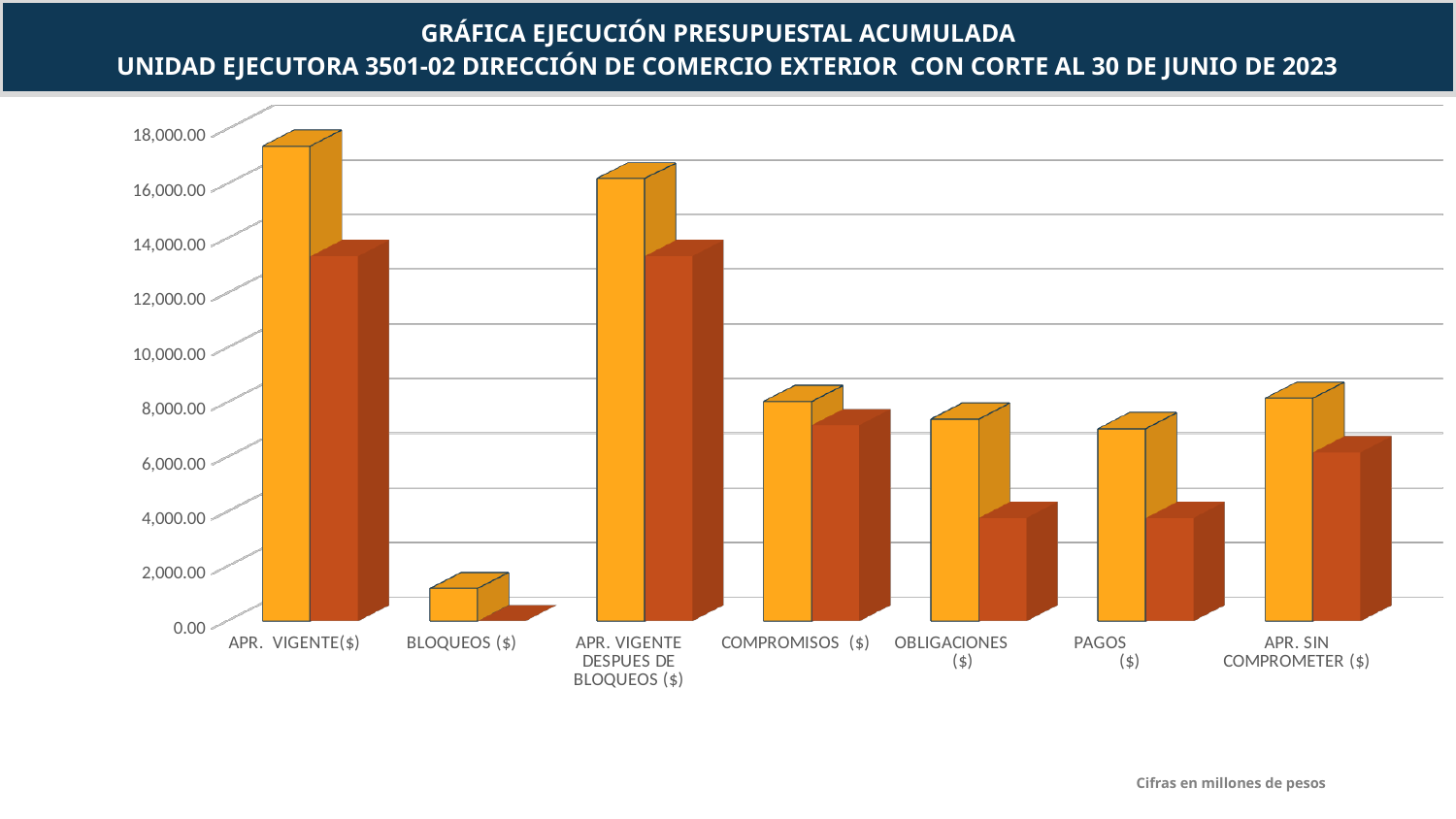
Is the yellow (front) bar for APR. VIGENTE($) greater or less than 16,000.00? greater Is the yellow (front) bar for PAGOS ($) greater or less than 6,000.00? greater What kind of chart is shown on the slide? bar chart Which category has the shortest yellow (front) bar? BLOQUEOS ($) Is the yellow (front) bar for BLOQUEOS ($) greater or less than 2,000.00? less According to the note at the bottom of the slide, in what units are the figures expressed? millones de pesos Which category has the tallest yellow (front) bar? APR. VIGENTE($) Which has the taller yellow (front) bar: COMPROMISOS ($) or OBLIGACIONES ($)? COMPROMISOS ($) How many categories are shown along the x axis of the chart? 7 Which has the taller yellow (front) bar: APR. VIGENTE($) or APR. VIGENTE DESPUES DE BLOQUEOS ($)? APR. VIGENTE($)